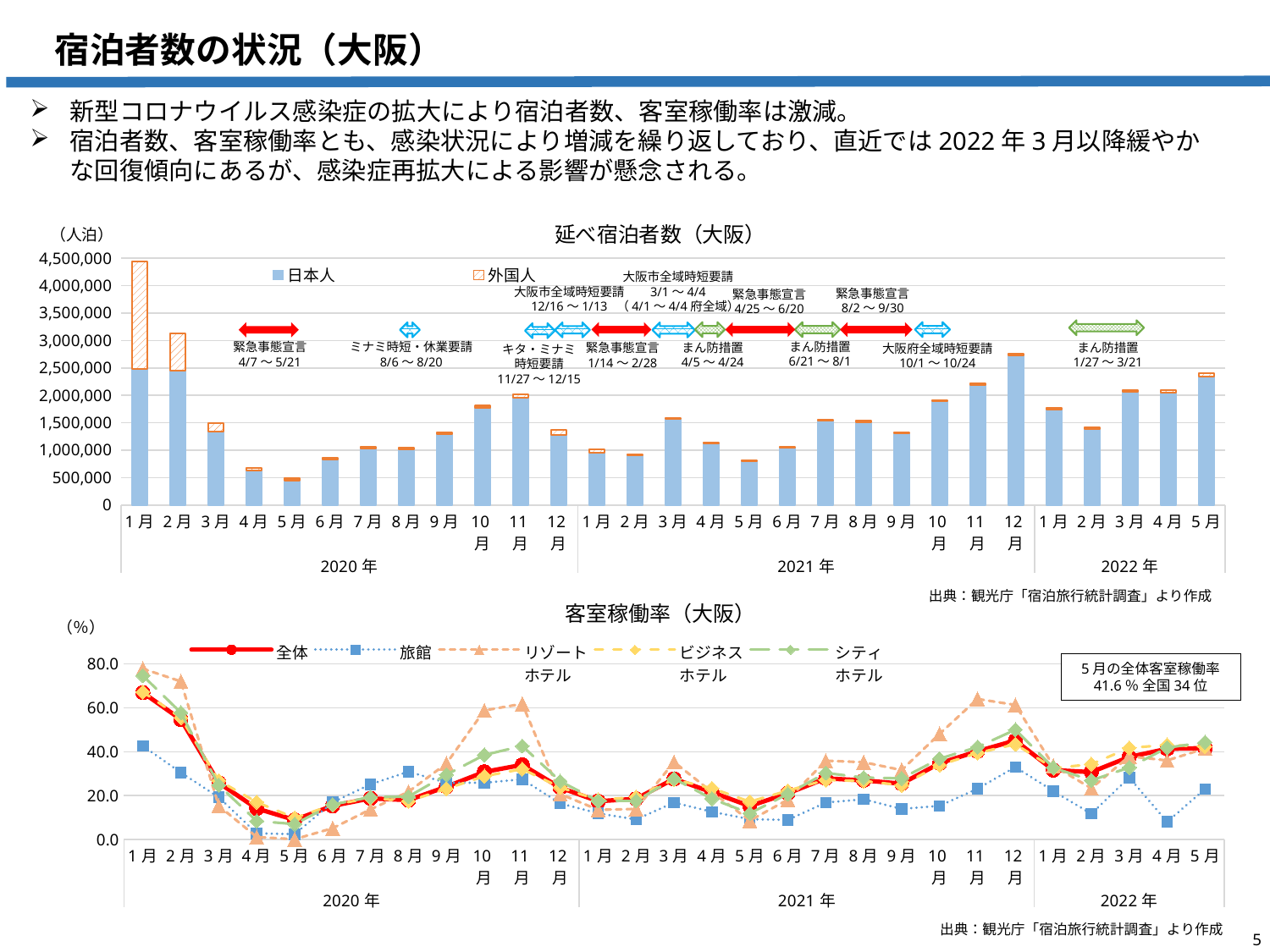
In the top chart 延べ宿泊者数（大阪）, how many series does the legend list? 2 In the bottom chart 客室稼働率（大阪）, what is the 全体 occupancy rate for 2022年5月 as stated in the text box? 41.6% In the bottom chart 客室稼働率（大阪）, how many series does the legend list? 5 What kind of chart is the top chart titled 延べ宿泊者数（大阪）? bar chart In the top chart 延べ宿泊者数（大阪）, do the totals rise or fall from 2020年1月 to 2020年5月? fall In the top chart 延べ宿泊者数（大阪）, is the total for 2020年1月 greater or less than 4,000,000? greater What kind of chart is the bottom chart titled 客室稼働率（大阪）? line chart In the bottom chart 客室稼働率（大阪）, which is larger for 全体: 2020年1月 or 2020年4月? 2020年1月 In the top chart 延べ宿泊者数（大阪）, is the total for 2020年5月 greater or less than 1,000,000? less In the bottom chart 客室稼働率（大阪）, which series has the highest value in 2021年11月? リゾートホテル In the top chart 延べ宿泊者数（大阪）, which month has the highest total number of overnight stays? 2020年1月 In the bottom chart 客室稼働率（大阪）, is the 全体 value for 2020年1月 greater or less than 60.0? greater